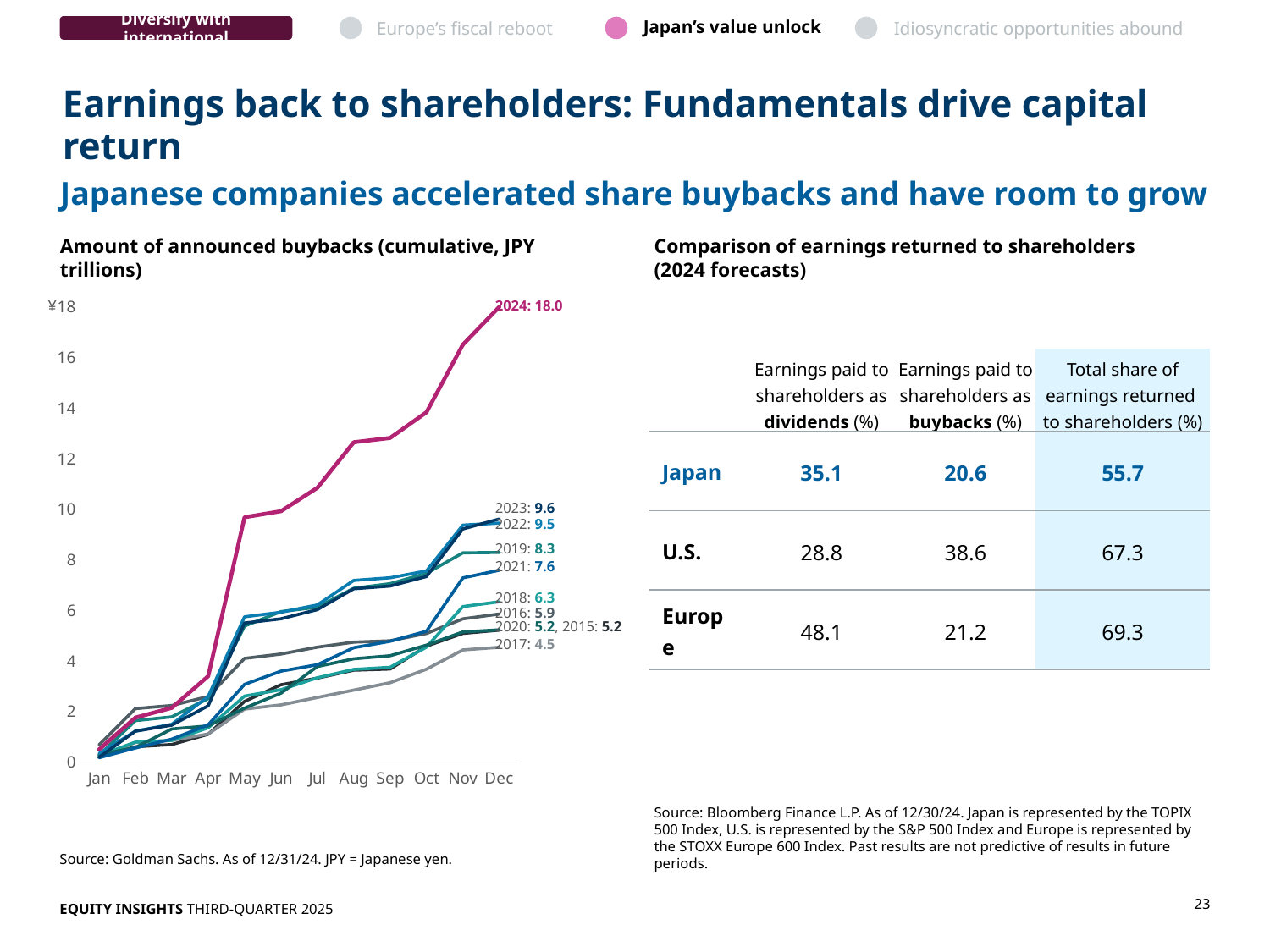
What is the difference between the year-end buyback amounts for 2024 and 2023? 8.4 Do the cumulative buyback lines rise or fall from January to December? rise What is the cumulative amount of announced buybacks at the end of 2023? 9.6 How many months are labelled on the x axis of the buybacks chart? 12 Which year has the lowest cumulative amount of announced buybacks at year end? 2017 Which year has the highest cumulative amount of announced buybacks at year end? 2024 What is the difference between the year-end buyback amounts for 2022 and 2021? 1.9 What is the cumulative amount of announced buybacks at the end of 2020? 5.2 Is the 2024 cumulative buyback value in June greater or less than 8? greater What is the cumulative amount of announced buybacks at the end of 2024? 18.0 Which year ended with a larger cumulative buyback amount, 2019 or 2021? 2019 What kind of chart is used to show the amount of announced buybacks? line chart